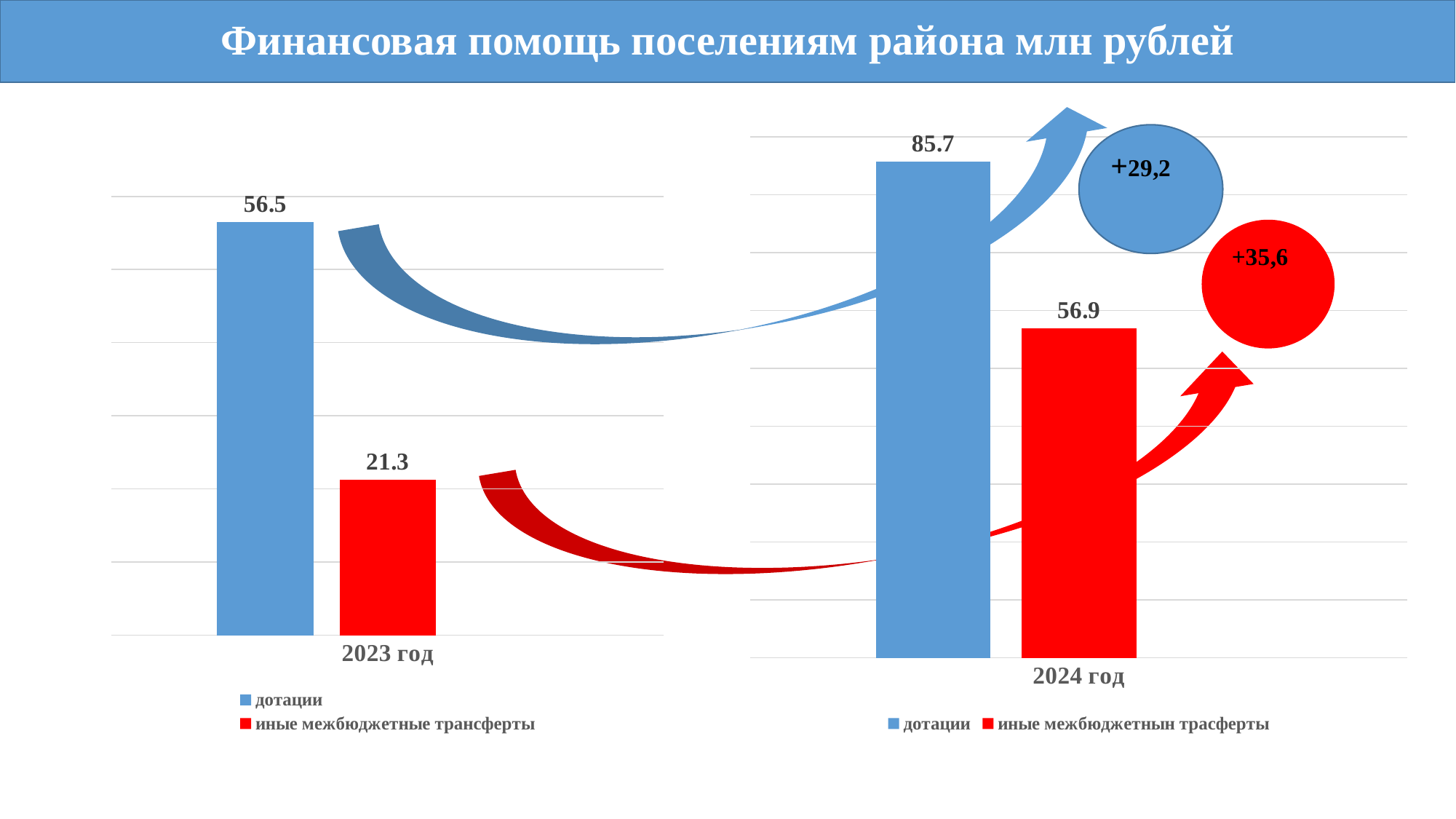
What colour are the дотации bars in both charts? blue How many series does the legend of the 2024 год chart list? 2 In the 2023 год chart, what is the value for иные межбюджетные трансферты? 21.3 In the 2023 год chart, which series has the higher value? дотации In the 2024 год chart, which series has the lower value? иные межбюджетнын трасферты In the 2024 год chart, what is the value for дотации? 85.7 In the 2024 год chart, what is the value for иные межбюджетнын трасферты? 56.9 Is the value for дотации larger in the 2023 год chart or in the 2024 год chart? 2024 год In the 2023 год chart, what is the value for дотации? 56.5 What type of chart is the 2023 год chart? bar chart In the 2024 год chart, what is the difference between дотации and иные межбюджетнын трасферты? 28.8 In the 2023 год chart, what is the difference between дотации and иные межбюджетные трансферты? 35.2